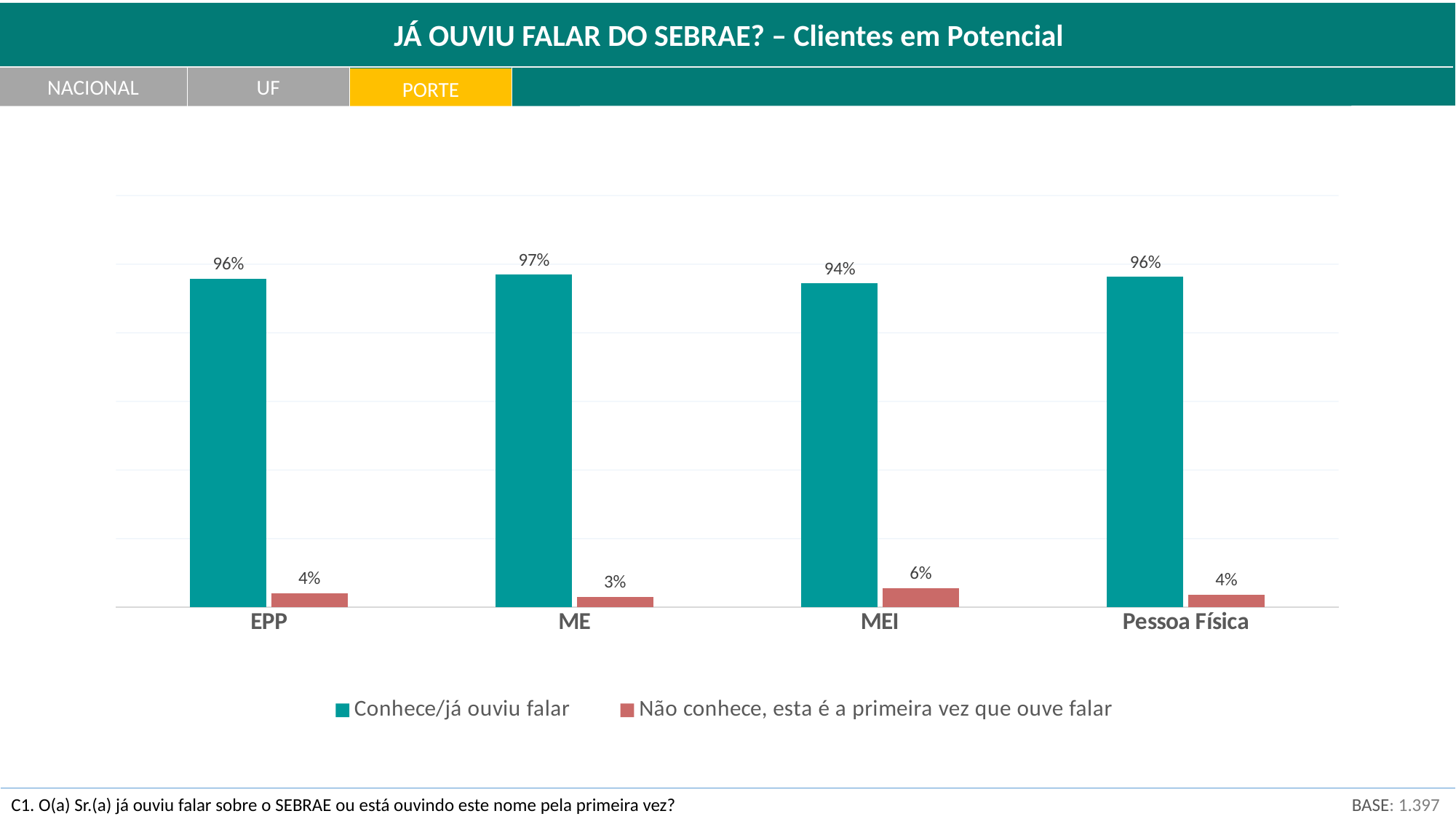
What is the value of "Não conhece, esta é a primeira vez que ouve falar" for MEI? 6% What kind of chart is shown on the slide? Bar chart What is the value of "Conhece/já ouviu falar" for ME? 97% Which is larger: the "Não conhece" value for MEI or for Pessoa Física? MEI Which category has the lowest value for "Conhece/já ouviu falar"? MEI How many series does the legend list? 2 What is the value of "Não conhece, esta é a primeira vez que ouve falar" for EPP? 4% How many categories are shown on the x axis? 4 Which category has the highest value for "Conhece/já ouviu falar"? ME What is the value of "Conhece/já ouviu falar" for Pessoa Física? 96% What is the difference between the "Conhece/já ouviu falar" values for ME and MEI? 3% Which category has the lowest value for "Não conhece, esta é a primeira vez que ouve falar"? ME